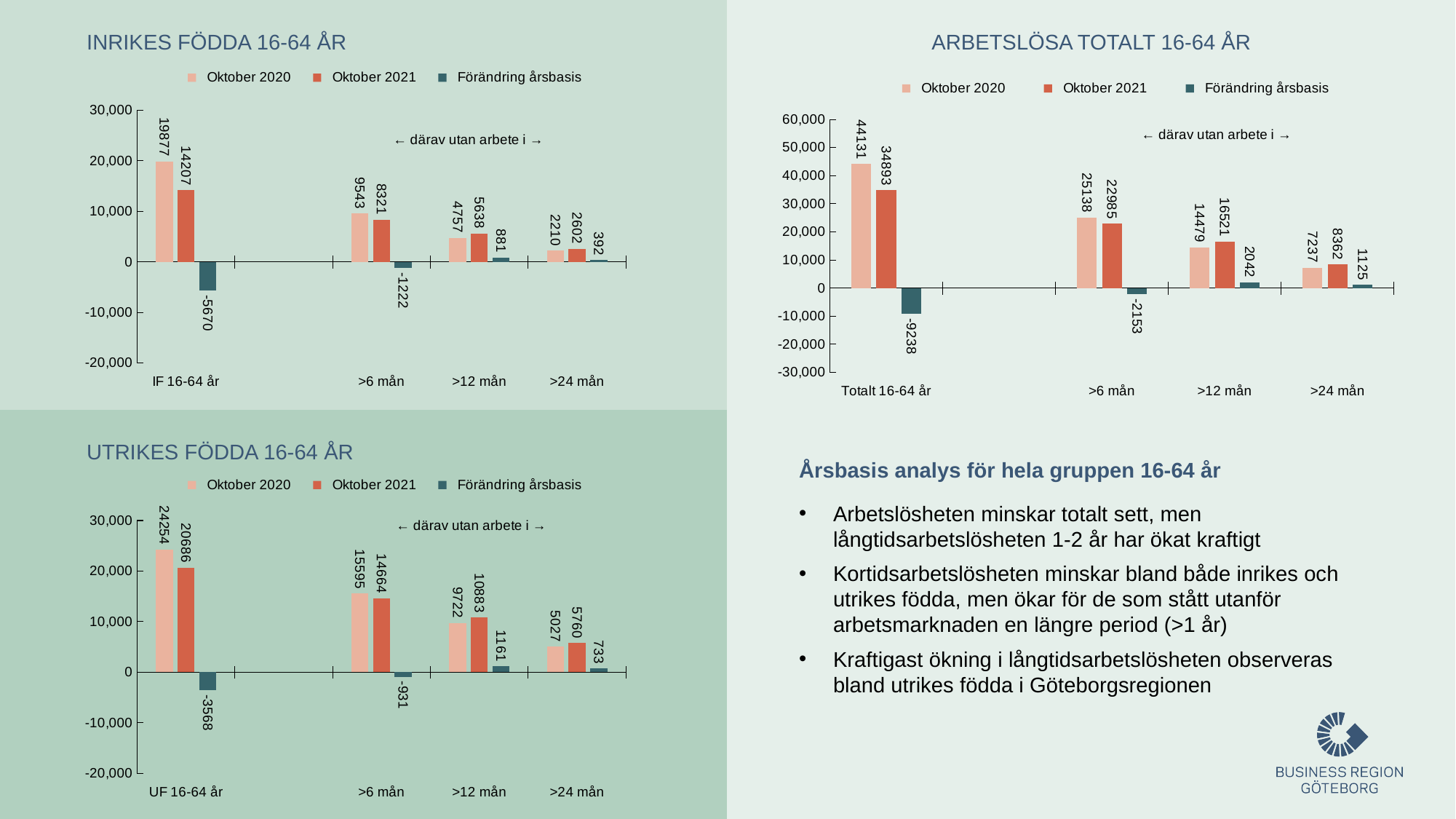
In the chart titled 'UTRIKES FÖDDA 16-64 ÅR', is the Oktober 2020 value for >6 mån greater or less than 10,000? greater In the chart titled 'ARBETSLÖSA TOTALT 16-64 ÅR', what is the Förändring årsbasis value for >24 mån? 1125 In the chart titled 'ARBETSLÖSA TOTALT 16-64 ÅR', what is the Oktober 2021 value for Totalt 16-64 år? 34893 In the chart titled 'UTRIKES FÖDDA 16-64 ÅR', what is the Oktober 2021 value for >24 mån? 5760 How many categories are shown on the x axis of the chart titled 'INRIKES FÖDDA 16-64 ÅR'? 4 In the chart titled 'INRIKES FÖDDA 16-64 ÅR', what is the Oktober 2020 value for IF 16-64 år? 19877 In the chart titled 'INRIKES FÖDDA 16-64 ÅR', what is the Förändring årsbasis value for >6 mån? -1222 In the chart titled 'UTRIKES FÖDDA 16-64 ÅR', which category has the lowest Förändring årsbasis value? UF 16-64 år How many series does the legend list in the chart titled 'ARBETSLÖSA TOTALT 16-64 ÅR'? 3 In the chart titled 'INRIKES FÖDDA 16-64 ÅR', what is the difference between the Oktober 2021 and Oktober 2020 values for >12 mån? 881 What kind of chart is the chart titled 'UTRIKES FÖDDA 16-64 ÅR'? Bar chart In the chart titled 'ARBETSLÖSA TOTALT 16-64 ÅR', which is larger for >12 mån: the Oktober 2020 value or the Oktober 2021 value? Oktober 2021